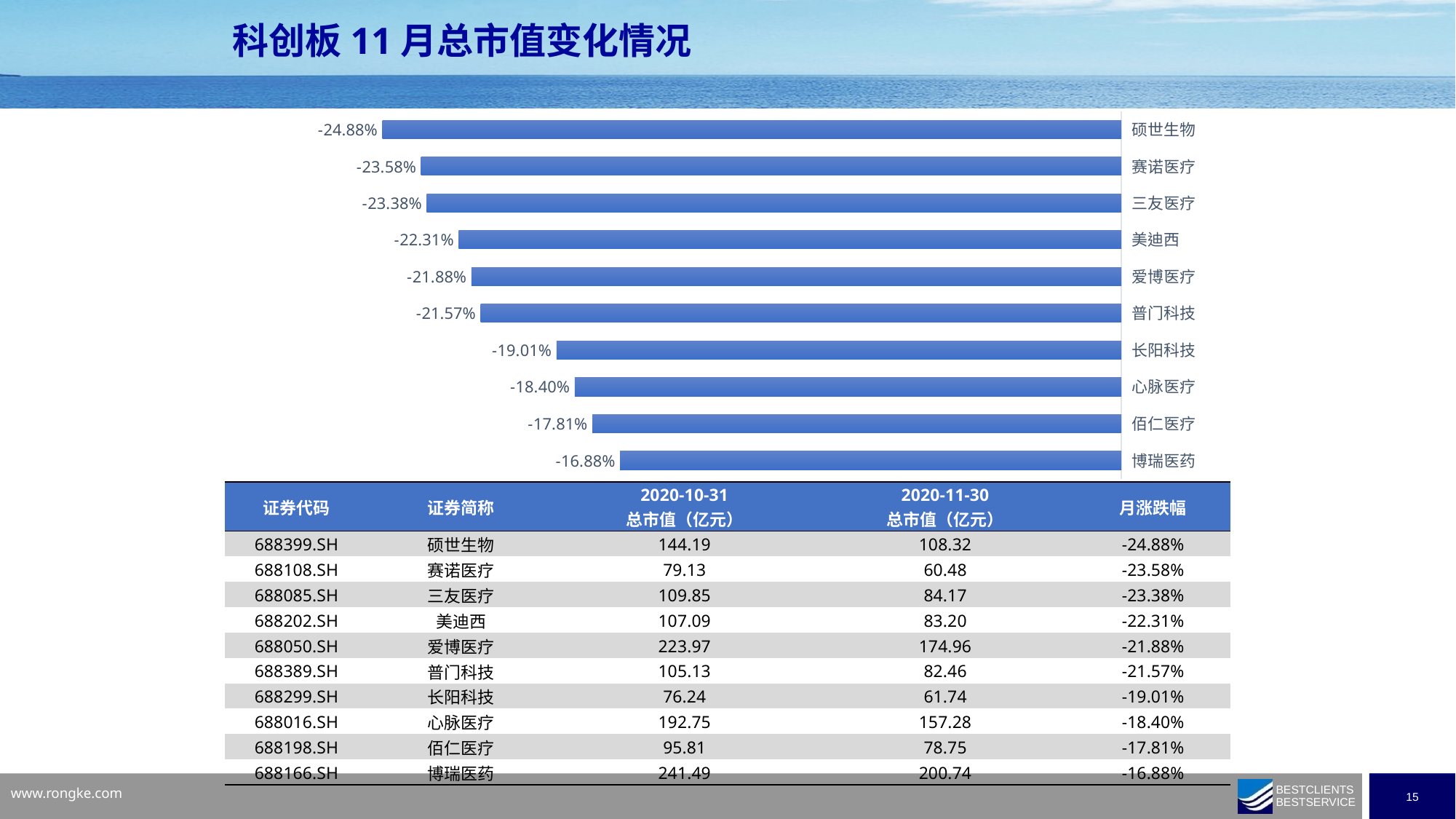
Do the bar lengths increase or decrease from the top bar to the bottom bar of the chart? Decrease What type of chart is shown on the slide? Bar chart What is the value shown for 长阳科技 in the bar chart? -19.01% What is the difference between the values for 硕世生物 and 博瑞医药 in the bar chart? 8.00 percentage points Which has a larger decline in the bar chart, 美迪西 or 心脉医疗? 美迪西 How many categories are shown in the bar chart? 10 Which category in the bar chart has the smallest decline (least negative value)? 博瑞医药 What is the value shown for 博瑞医药 in the bar chart? -16.88% What is the value shown for 爱博医疗 in the bar chart? -21.88% What is the title of the slide containing the bar chart? 科创板 11 月总市值变化情况 Which category in the bar chart has the largest decline (most negative value)? 硕世生物 What is the value shown for 硕世生物 in the bar chart? -24.88%